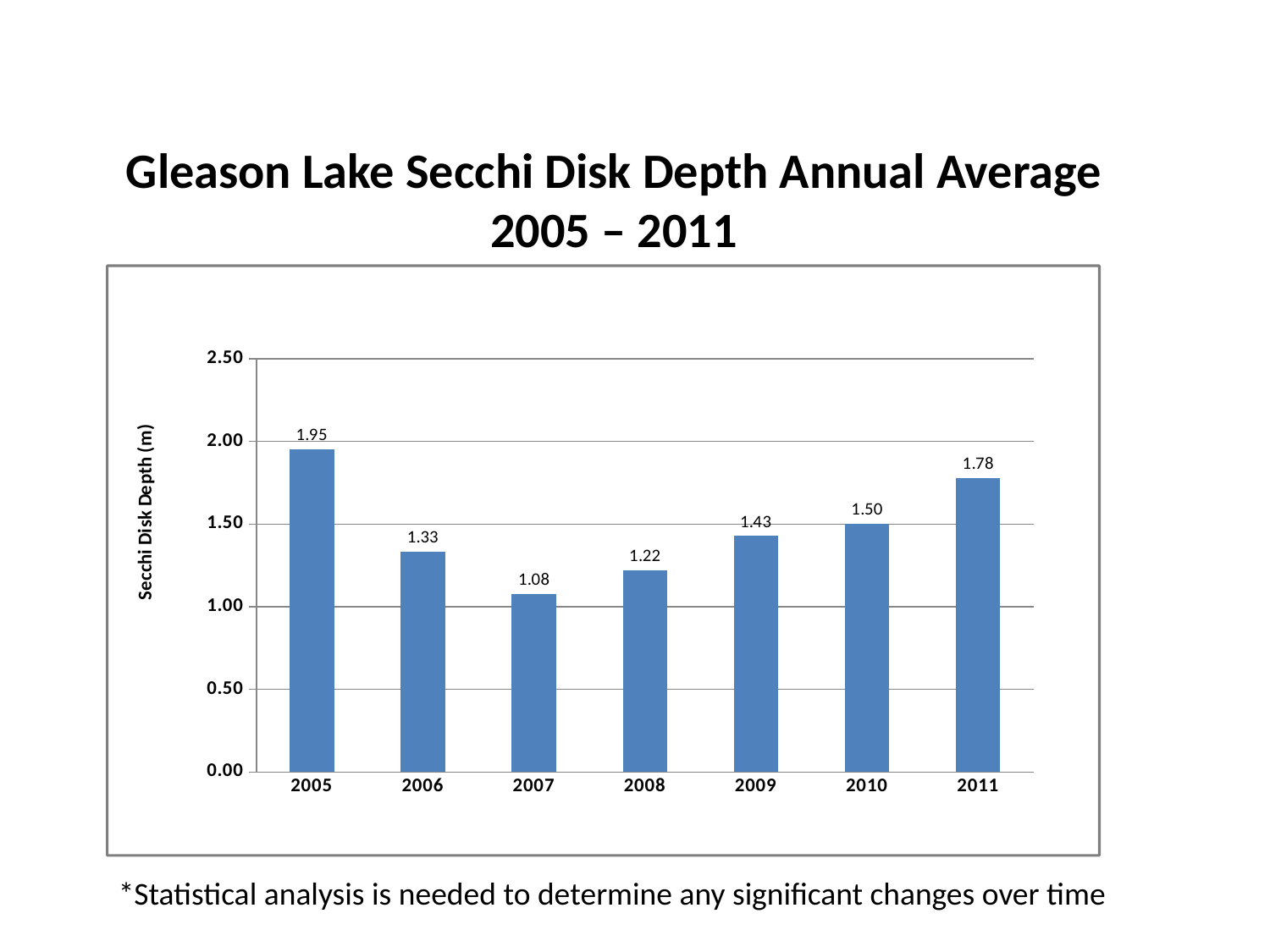
Which year has a larger Secchi disk depth, 2006 or 2009? 2009 How many years are shown on the x axis? 7 Which year has the lowest Secchi disk depth? 2007 What is the Secchi disk depth for 2008? 1.22 What kind of chart is shown on the slide? bar chart Which year has the highest Secchi disk depth? 2005 What is the difference between the Secchi disk depth in 2011 and in 2010? 0.28 What is the difference between the Secchi disk depth in 2005 and in 2007? 0.87 What is the Secchi disk depth for 2005? 1.95 What is the label of the y axis? Secchi Disk Depth (m) What is the Secchi disk depth for 2011? 1.78 Is the value for 2010 greater or less than 1.00? greater